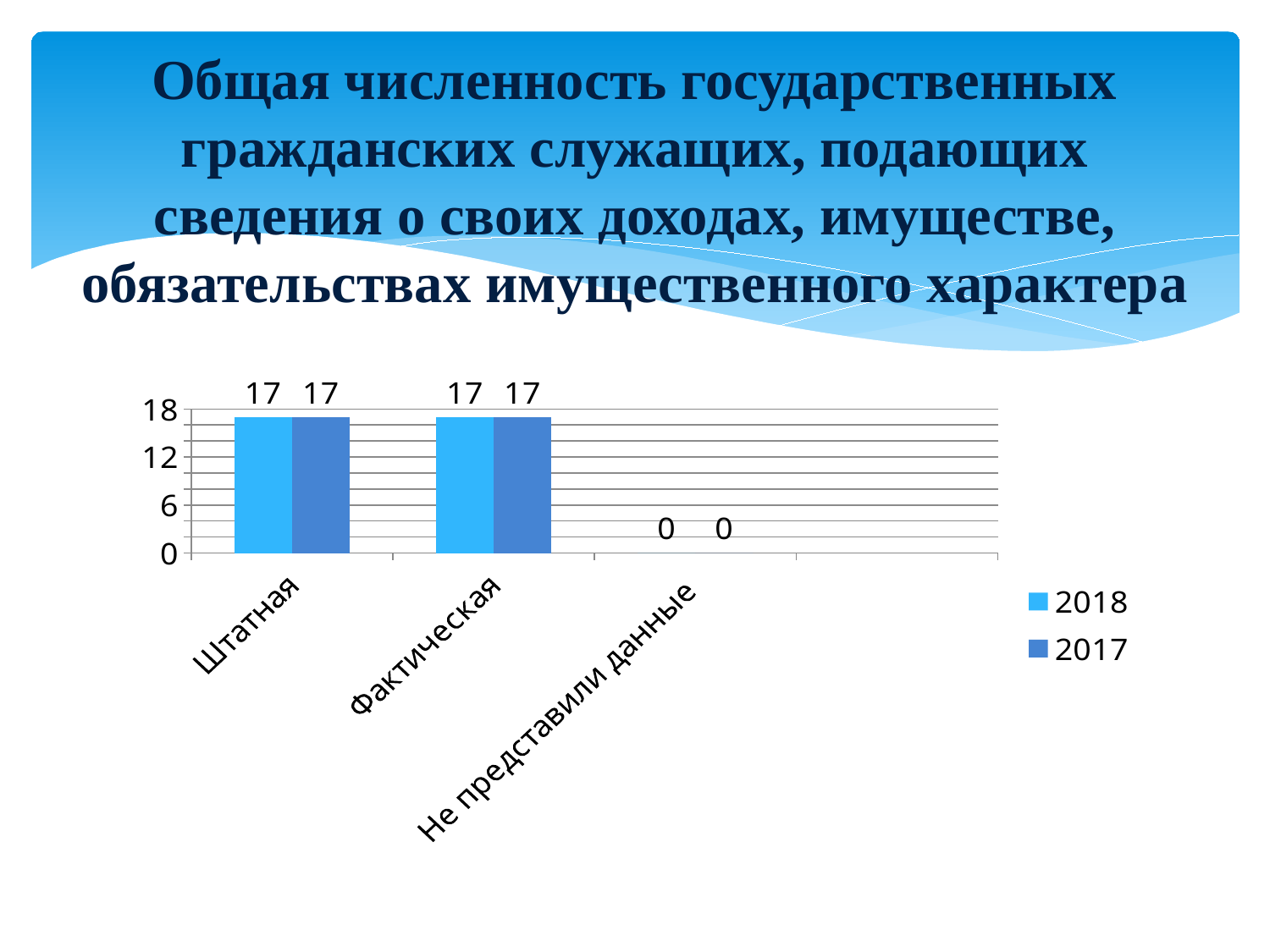
Which is larger: the 2017 value for Штатная or the 2017 value for Не представили данные? Штатная What is the value for Фактическая in the 2017 series? 17 How many categories are shown on the x axis? 3 Which category has the lowest value in the 2018 series? Не представили данные What is the value for Штатная in the 2018 series? 17 What is the value for Не представили данные in the 2018 series? 0 What is the difference between the 2018 and 2017 values for Фактическая? 0 What is the value for Не представили данные in the 2017 series? 0 What kind of chart is shown on the slide? bar chart What is the difference between the 2018 values for Штатная and Не представили данные? 17 How many series does the legend list? 2 Is the 2018 value for Фактическая greater or less than 12? greater